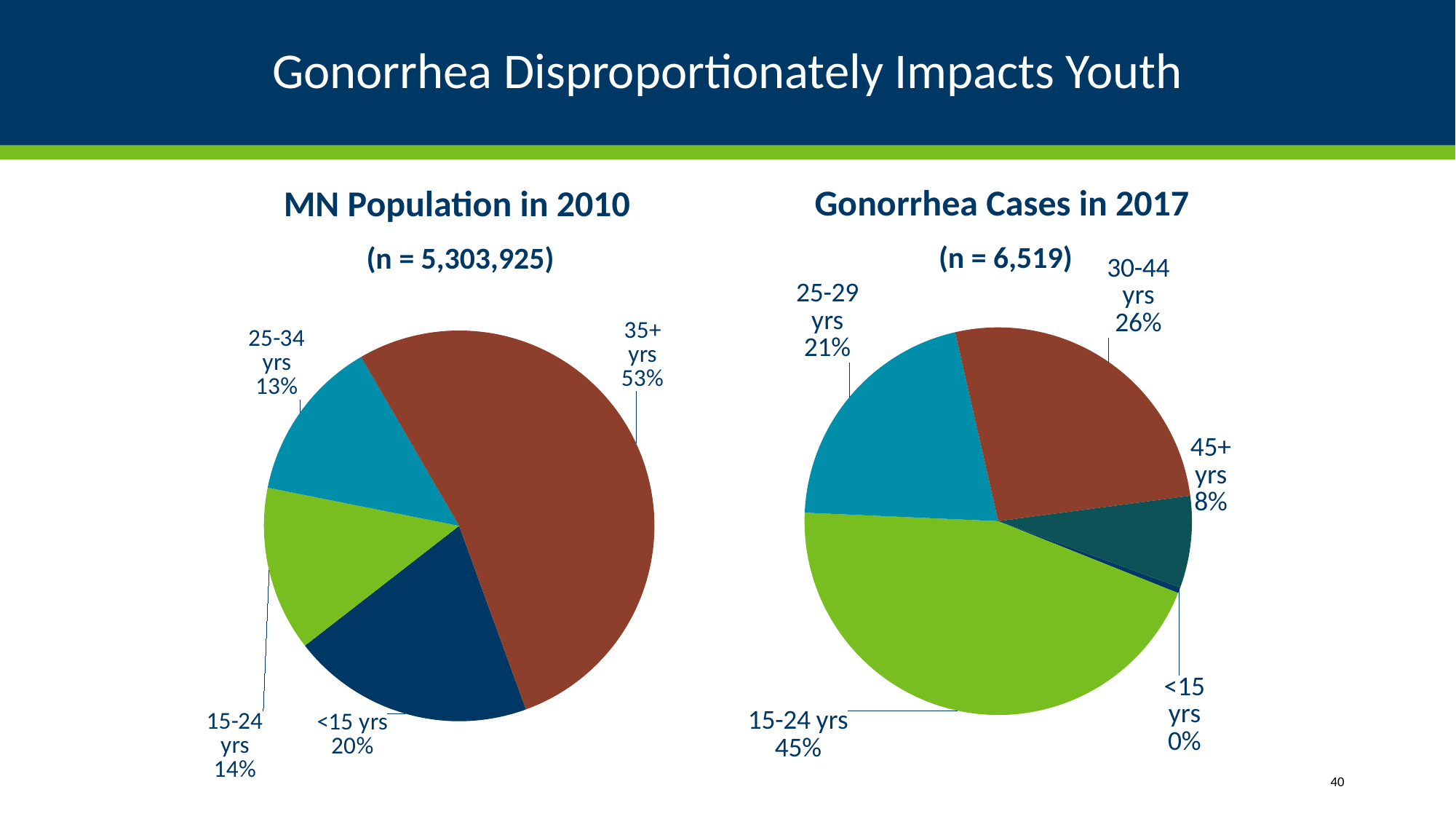
What is the n value shown under the 'Gonorrhea Cases in 2017' title? n = 6,519 In the 'Gonorrhea Cases in 2017' chart, what share of cases is 15-24 yrs? 45% In the 'Gonorrhea Cases in 2017' chart, which age group has the largest slice? 15-24 yrs In the 'MN Population in 2010' chart, which age group has the smallest slice? 25-34 yrs In the 'Gonorrhea Cases in 2017' chart, what is the difference between the 30-44 yrs and 25-29 yrs percentages? 5 percentage points In the 'Gonorrhea Cases in 2017' chart, which age group has the smallest slice? <15 yrs In the 'MN Population in 2010' chart, which age group has the largest slice? 35+ yrs In the 'MN Population in 2010' chart, what share of the population is 35+ yrs? 53% In the 'Gonorrhea Cases in 2017' chart, what percentage is shown for 45+ yrs? 8% What type of chart is used for 'Gonorrhea Cases in 2017'? Pie chart In the 'MN Population in 2010' chart, how many age groups are shown? 4 In the 'MN Population in 2010' chart, what percentage is shown for 15-24 yrs? 14%